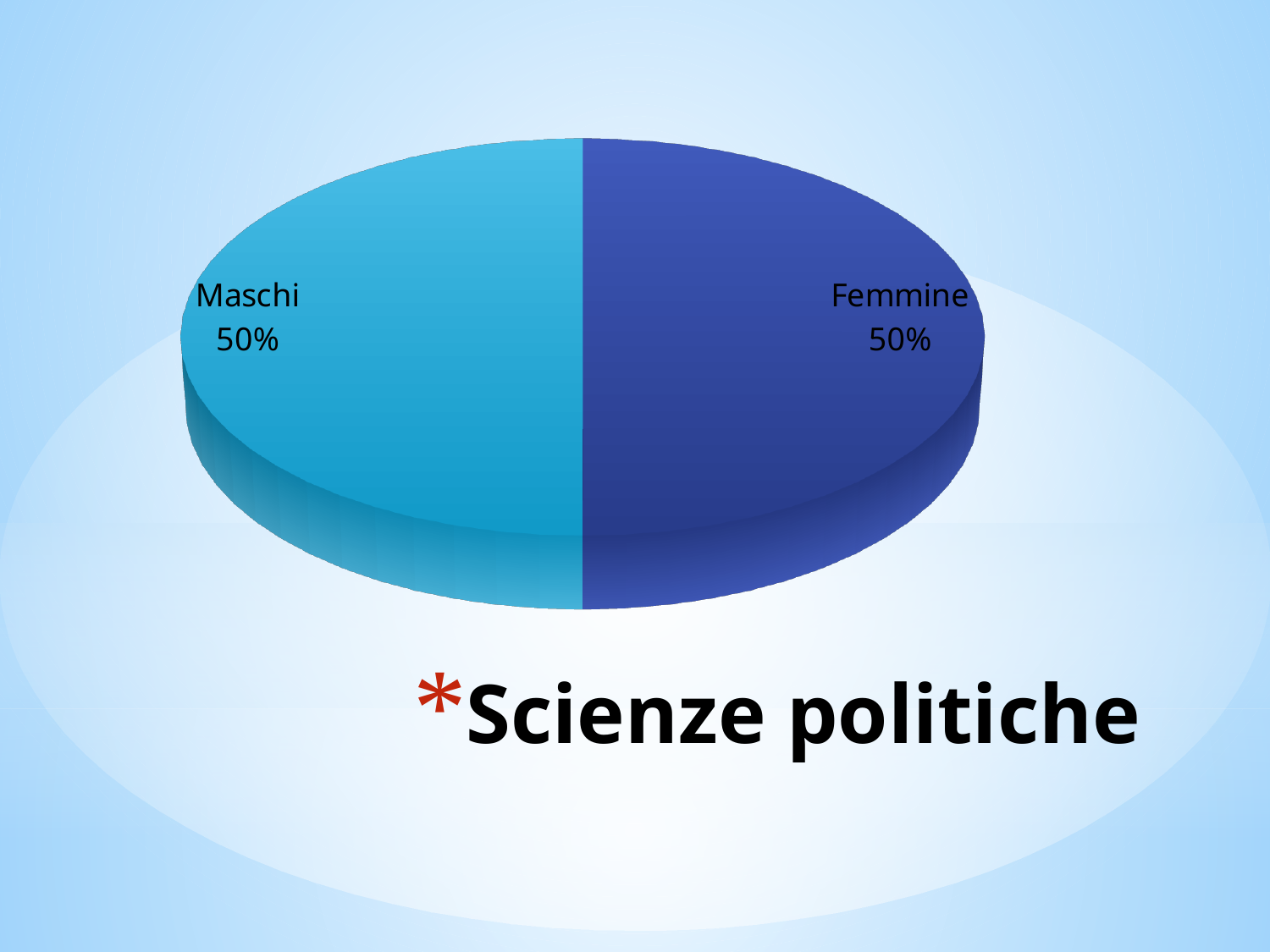
What text appears below the pie chart? Scienze politiche Which slice is shown in dark blue? Femmine What share of the pie does Femmine represent? 50% How many slices does the pie chart have? 2 What share of the pie does Maschi represent? 50% What is the difference between the Maschi and Femmine shares? 0% What kind of chart is shown on the slide? pie chart Is the value for Femmine greater or less than 60%? less Is the value for Maschi greater or less than 40%? greater What is the combined share of Maschi and Femmine? 100%